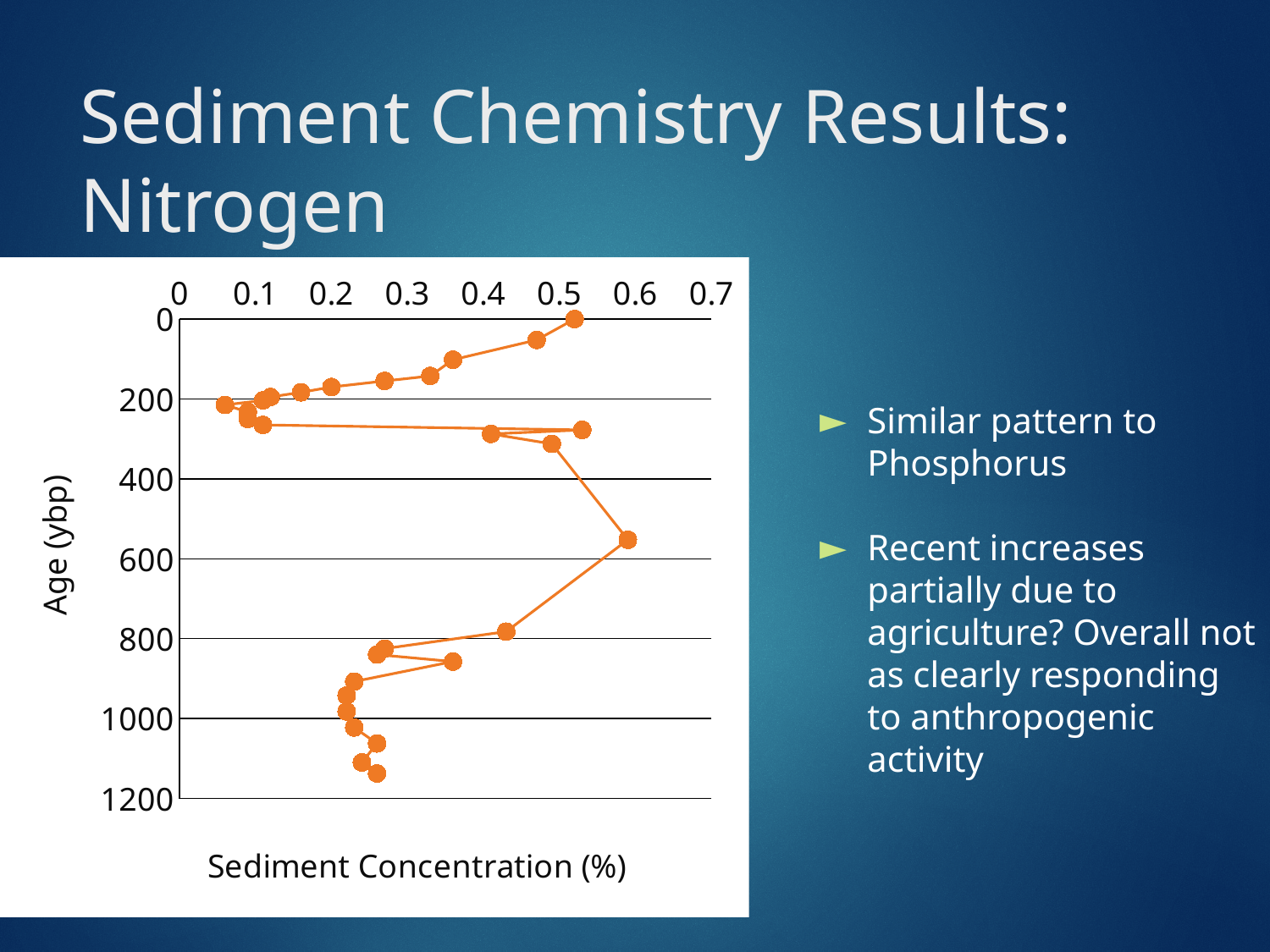
Are the sediment concentrations for ages between 900 and 1000 ybp greater or less than 0.3? less Is the sediment concentration at the point near 550 ybp greater or less than 0.5? greater What is the title of the horizontal axis of the chart? Sediment Concentration (%) What kind of chart is shown on the slide? Line chart with markers (scatter plot) What is the title of the vertical axis of the chart? Age (ybp) What is the largest value shown on the horizontal (Sediment Concentration) axis? 0.7 Is the lowest sediment concentration on the chart found between 0 and 400 ybp or between 800 and 1200 ybp? between 0 and 400 ybp Is the sediment concentration at age 0 ybp greater or less than 0.4? greater Which has the larger sediment concentration: the point at 0 ybp or the point near 1000 ybp? The point at 0 ybp Is the highest sediment concentration on the chart found at an age younger or older than 400 ybp? older What is the largest value shown on the vertical (Age) axis? 1200